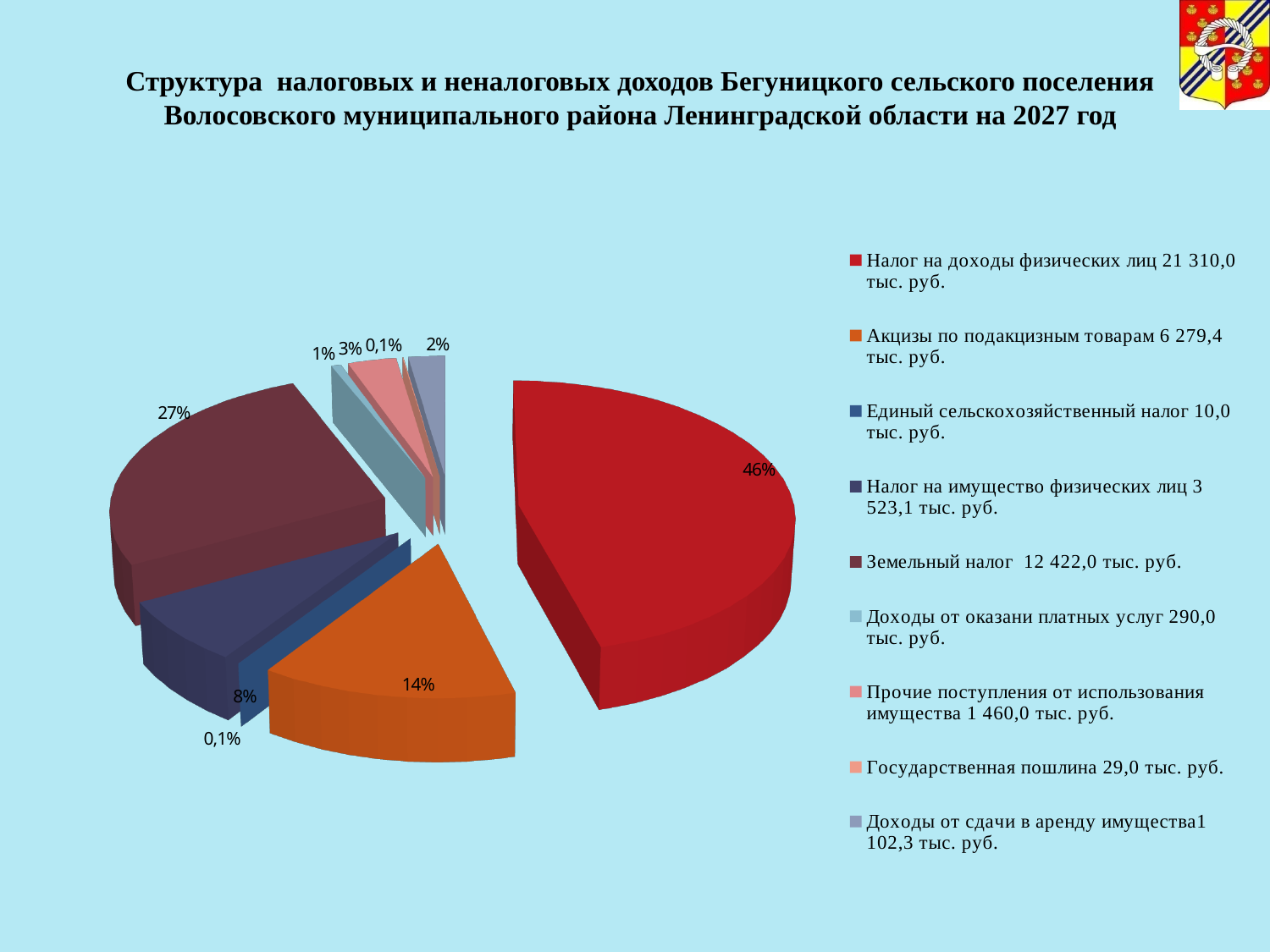
Which is larger: the share for "Земельный налог" or the share for "Акцизы по подакцизным товарам"? Земельный налог By how many percentage points does the share of "Налог на доходы физических лиц" exceed the share of "Земельный налог"? 19 What share of the pie does "Земельный налог" take? 27% What share of the pie does "Прочие поступления от использования имущества" take? 3% What share of the pie does "Акцизы по подакцизным товарам" take? 14% According to the legend, what amount is given for "Государственная пошлина"? 29,0 тыс. руб. Which category has the largest slice of the pie? Налог на доходы физических лиц What kind of chart is shown on the slide? pie chart According to the legend, what amount is given for "Земельный налог"? 12 422,0 тыс. руб. How many slices does the pie chart have? 9